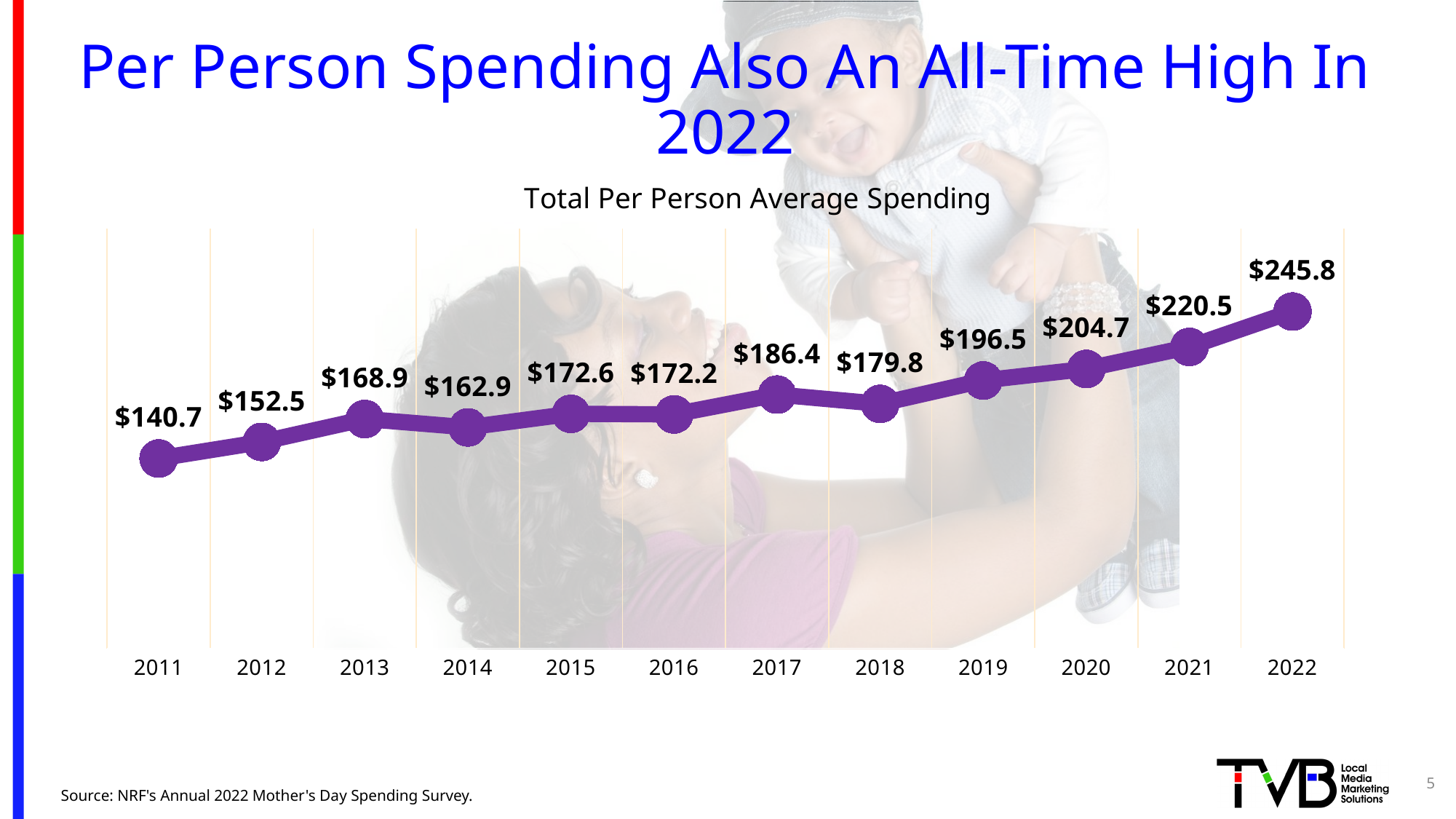
How much higher is the per person spending in 2022 than in 2021? $25.3 Which year has the lowest total per person average spending? 2011 What is the title of the chart? Total Per Person Average Spending What is the total per person average spending for 2018? $179.8 Which year has the highest total per person average spending? 2022 What is the total per person average spending for 2011? $140.7 What is the total per person average spending for 2022? $245.8 Does per person spending generally rise or fall from 2011 to 2022? Rise What kind of chart is shown on the slide? Line chart What is the difference in per person spending between 2017 and 2018? $6.6 How many years are plotted on the chart? 12 Which year has higher per person spending, 2013 or 2014? 2013